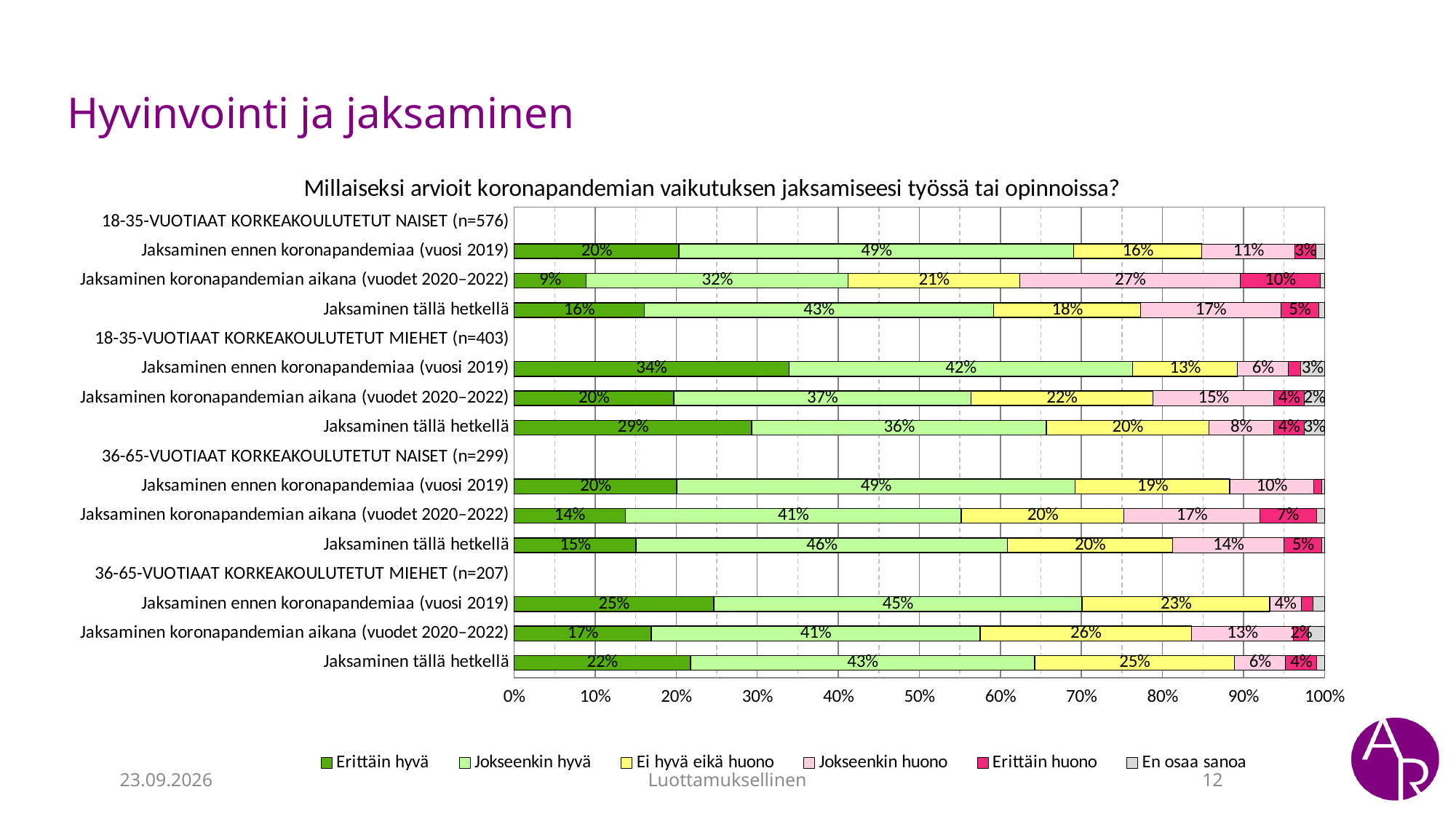
For 18-35-vuotiaat korkeakoulutetut miehet, what is the 'Jokseenkin hyvä' share for 'Jaksaminen ennen koronapandemiaa (vuosi 2019)'? 42% Which group has the highest 'Erittäin hyvä' share for 'Jaksaminen ennen koronapandemiaa (vuosi 2019)'? 18-35-vuotiaat korkeakoulutetut miehet For 18-35-vuotiaat korkeakoulutetut naiset, what is the 'Erittäin hyvä' share for 'Jaksaminen koronapandemian aikana (vuodet 2020–2022)'? 9% What type of chart is shown on the slide? Stacked bar chart How many respondent groups are shown in the chart? 4 How many series does the legend list? 6 For 18-35-vuotiaat korkeakoulutetut naiset, what is the 'Erittäin huono' share for 'Jaksaminen koronapandemian aikana (vuodet 2020–2022)'? 10% For 36-65-vuotiaat korkeakoulutetut miehet, what is the 'Ei hyvä eikä huono' share for 'Jaksaminen koronapandemian aikana (vuodet 2020–2022)'? 26% For 18-35-vuotiaat korkeakoulutetut naiset, what is the difference between the 'Erittäin hyvä' share before the pandemic (vuosi 2019) and during the pandemic (vuodet 2020–2022)? 11 percentage points What is the title of the chart? Millaiseksi arvioit koronapandemian vaikutuksen jaksamiseesi työssä tai opinnoissa? For 36-65-vuotiaat korkeakoulutetut miehet, which is larger: the 'Jokseenkin hyvä' share for 'Jaksaminen ennen koronapandemiaa (vuosi 2019)' or for 'Jaksaminen tällä hetkellä'? Jaksaminen ennen koronapandemiaa (vuosi 2019) For 36-65-vuotiaat korkeakoulutetut naiset, what is the 'Jokseenkin huono' share for 'Jaksaminen tällä hetkellä'? 14%